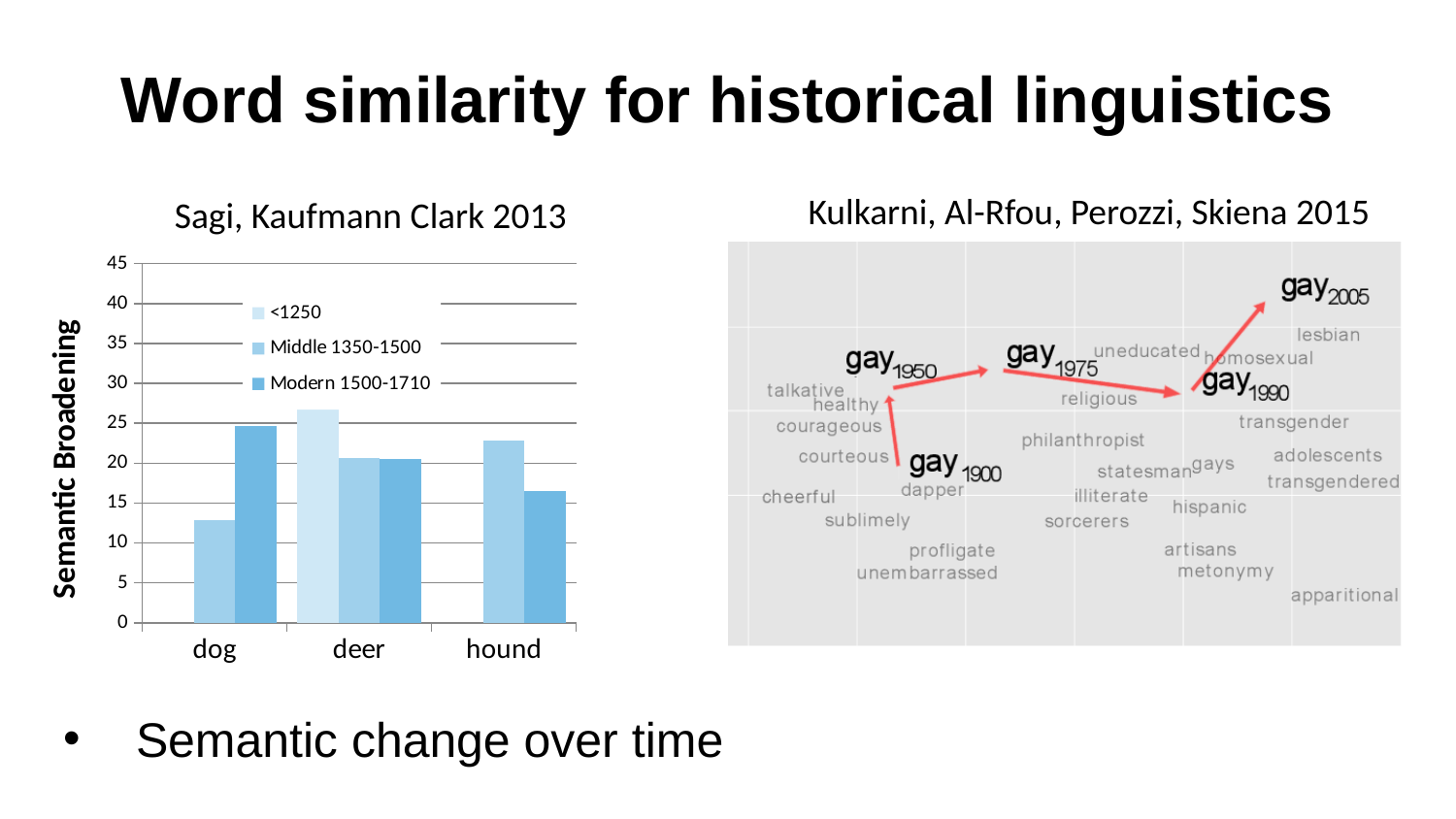
In the left bar chart, which series does the lightest blue colour represent? <1250 In the left bar chart, is the value for 'dog' in the Modern 1500-1710 series greater or less than 20? greater In the left bar chart, how many series does the legend list? 3 In the left bar chart, is the value for 'dog' in the Middle 1350-1500 series greater or less than 15? less In the left bar chart, is the value for 'hound' in the Modern 1500-1710 series greater or less than 20? less In the left bar chart, how many word categories are shown on the x axis? 3 In the left bar chart, for 'dog', which series has the larger value: Middle 1350-1500 or Modern 1500-1710? Modern 1500-1710 In the left bar chart, what is the label of the vertical axis? Semantic Broadening In the left bar chart, for 'hound', which series has the larger value: Middle 1350-1500 or Modern 1500-1710? Middle 1350-1500 In the left bar chart, which category has the lowest bar overall? dog What kind of chart is the one on the left titled 'Sagi, Kaufmann Clark 2013'? bar chart